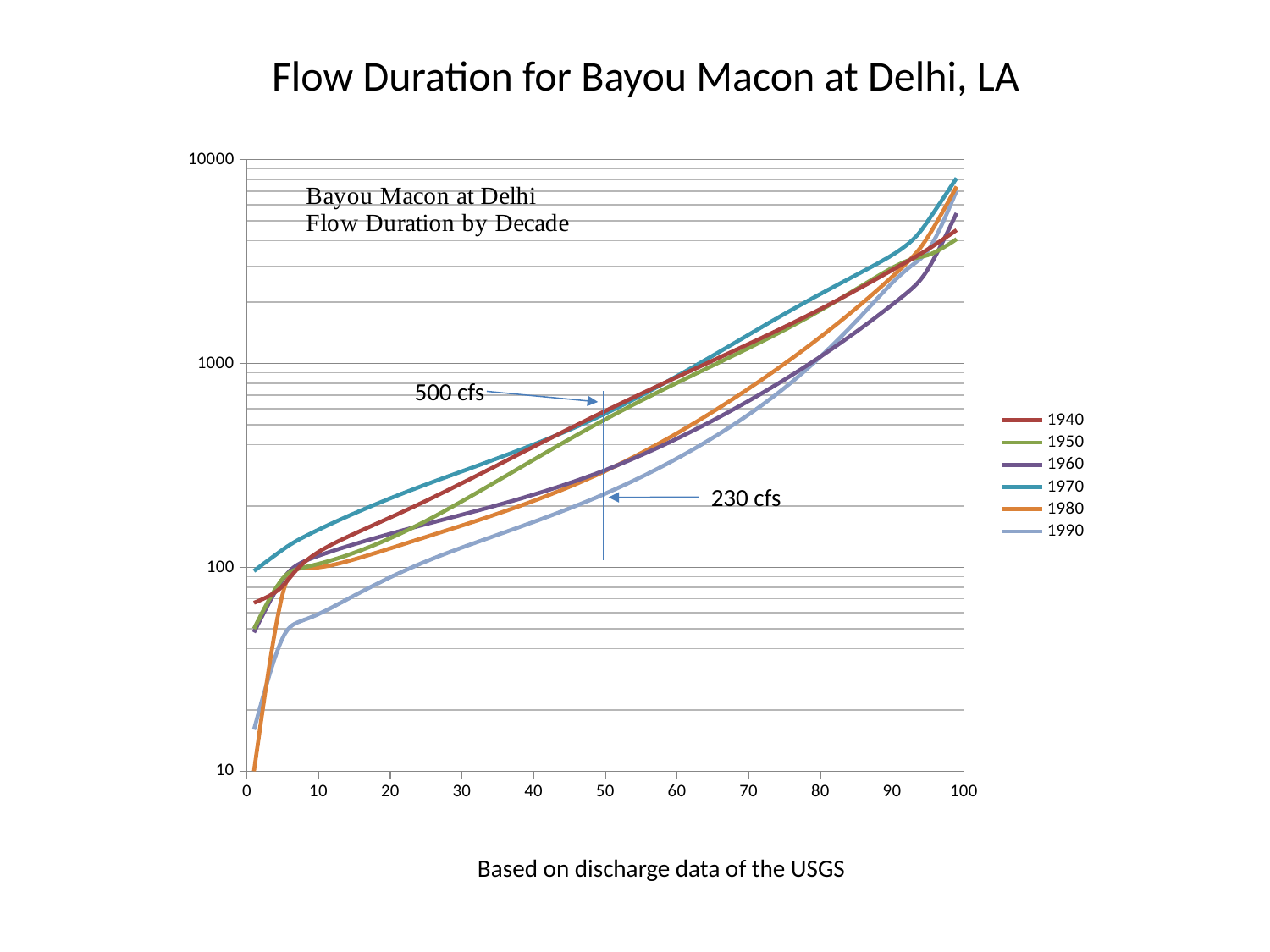
At x = 50, is the value for the 1990 series greater or less than 1000? less At x = 20, which series has the lowest value? 1990 Which decades are listed in the legend? 1940, 1950, 1960, 1970, 1980, 1990 At x = 10, is the value for the 1990 series greater or less than 100? less Do the flow values rise or fall as the x-axis value increases? rise At x = 50, which series has the higher value, 1970 or 1990? 1970 What kind of chart is shown on the slide? line chart How many series does the legend list? 6 What flow value is annotated at the lower arrow near x = 50? 230 cfs At x = 20, which series has the highest value? 1970 What flow value is annotated at the upper arrow near x = 50? 500 cfs At x = 90, is the value for the 1970 series greater or less than 1000? greater